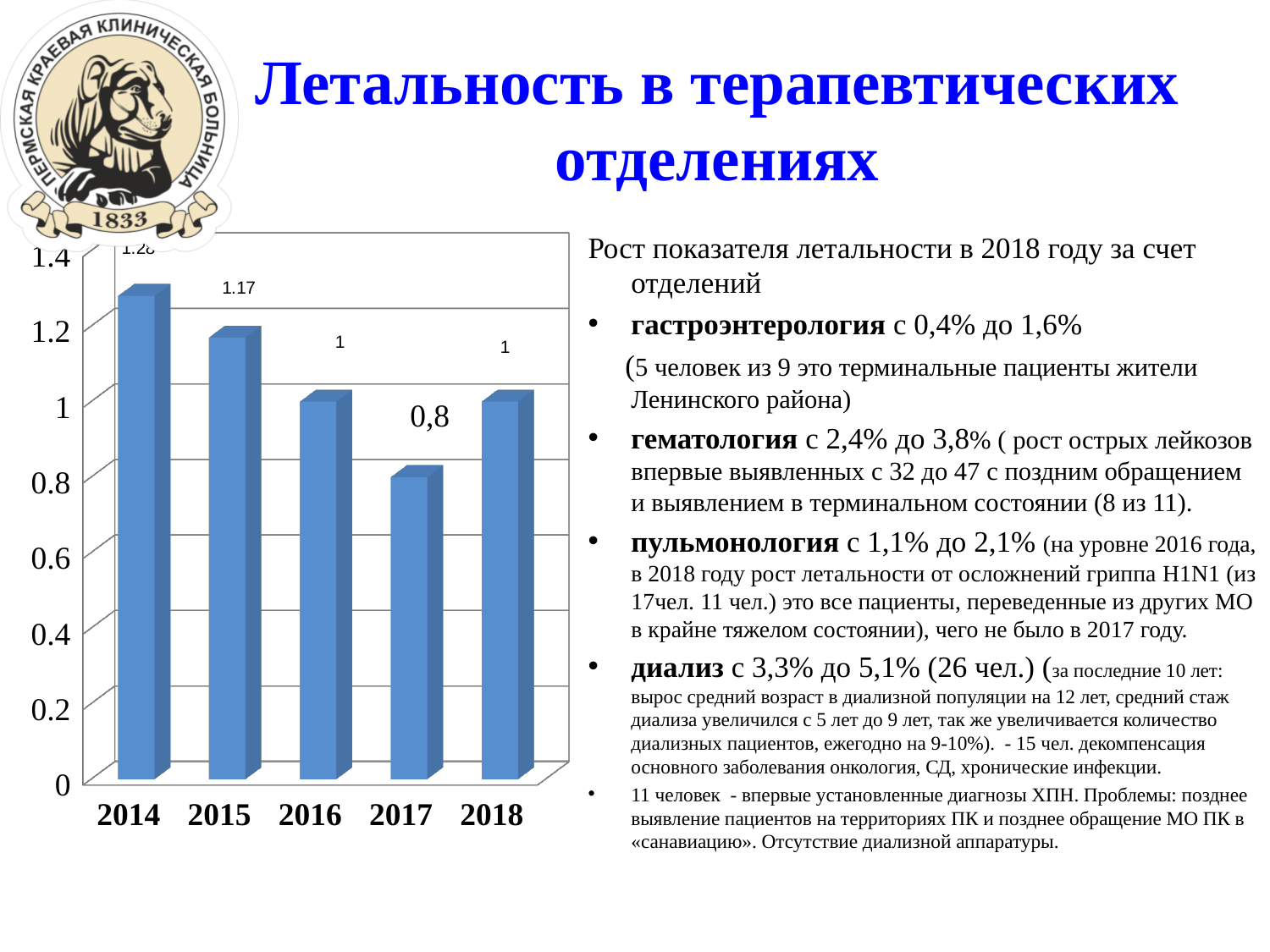
What is the value for 2017? 0,8 How many years are shown on the x axis? 5 Which year has the highest value? 2014 What is the value for 2015? 1.17 What is the value for 2016? 1 What is the value for 2018? 1 What is the difference between the values for 2015 and 2017? 0.37 Do the values rise or fall from 2014 to 2017? fall Which year has the lowest value? 2017 Is the value for 2014 greater or less than 1.2? greater What kind of chart is shown on the slide? bar chart Which is larger, the value for 2015 or the value for 2016? 2015